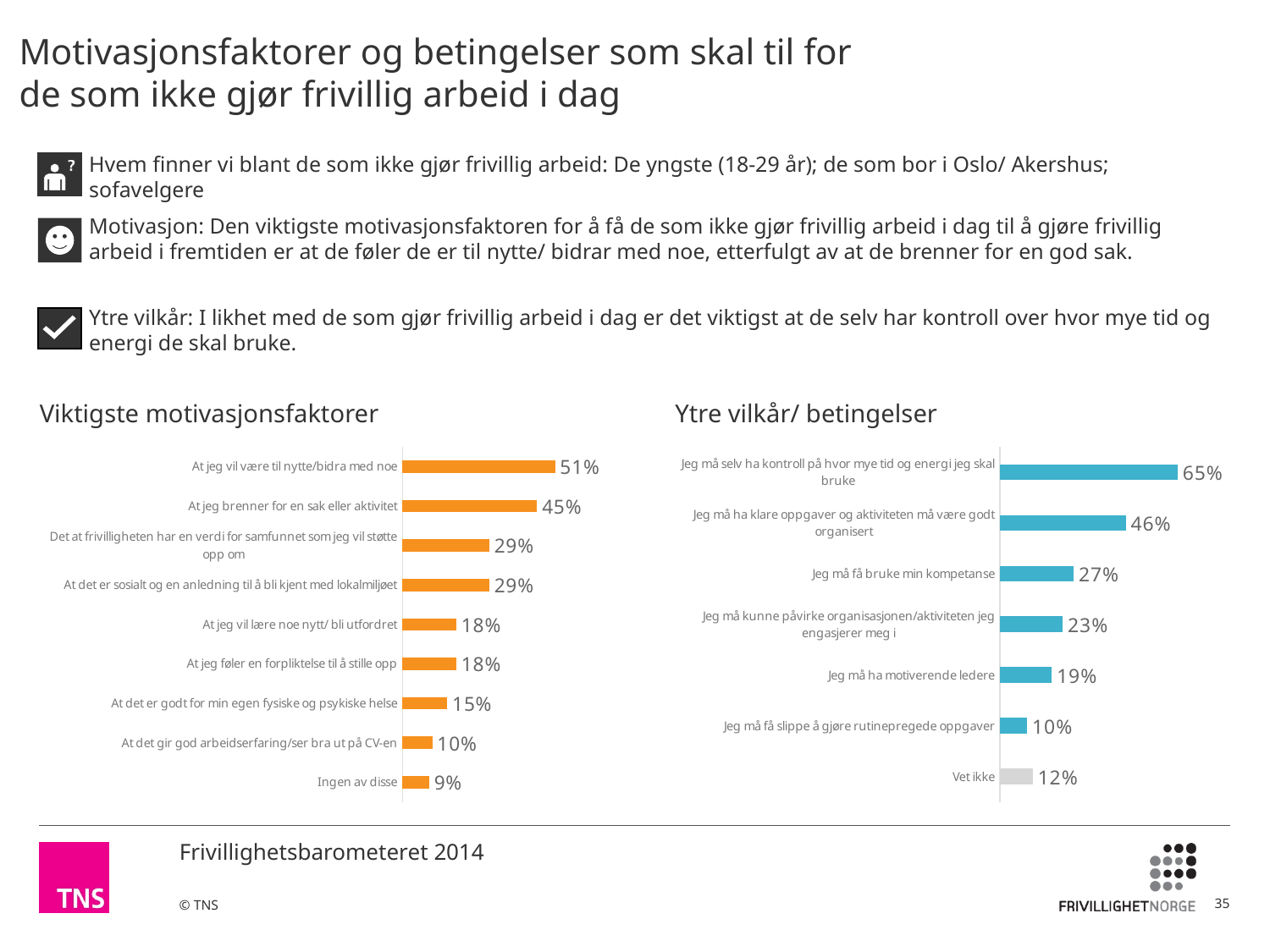
In the 'Viktigste motivasjonsfaktorer' chart, how many categories are shown? 9 In the 'Ytre vilkår/ betingelser' chart, what is the value for 'Jeg må ha klare oppgaver og aktiviteten må være godt organisert'? 46% In the 'Ytre vilkår/ betingelser' chart, which is larger: 'Jeg må ha motiverende ledere' or 'Vet ikke'? Jeg må ha motiverende ledere In the 'Ytre vilkår/ betingelser' chart, what is the difference between 'Jeg må få bruke min kompetanse' and 'Jeg må kunne påvirke organisasjonen/aktiviteten jeg engasjerer meg i'? 4 percentage points In the 'Viktigste motivasjonsfaktorer' chart, what is the value for 'At det gir god arbeidserfaring/ser bra ut på CV-en'? 10% In the 'Viktigste motivasjonsfaktorer' chart, what is the value for 'At jeg vil være til nytte/bidra med noe'? 51% In the 'Ytre vilkår/ betingelser' chart, how many categories are shown? 7 In the 'Viktigste motivasjonsfaktorer' chart, which category has the lowest value? Ingen av disse In the 'Ytre vilkår/ betingelser' chart, which category has the highest value? Jeg må selv ha kontroll på hvor mye tid og energi jeg skal bruke What type of chart is the 'Viktigste motivasjonsfaktorer' chart? Bar chart In the 'Ytre vilkår/ betingelser' chart, which bar is coloured grey instead of blue? Vet ikke In the 'Viktigste motivasjonsfaktorer' chart, what is the difference between 'At jeg vil være til nytte/bidra med noe' and 'At jeg brenner for en sak eller aktivitet'? 6 percentage points